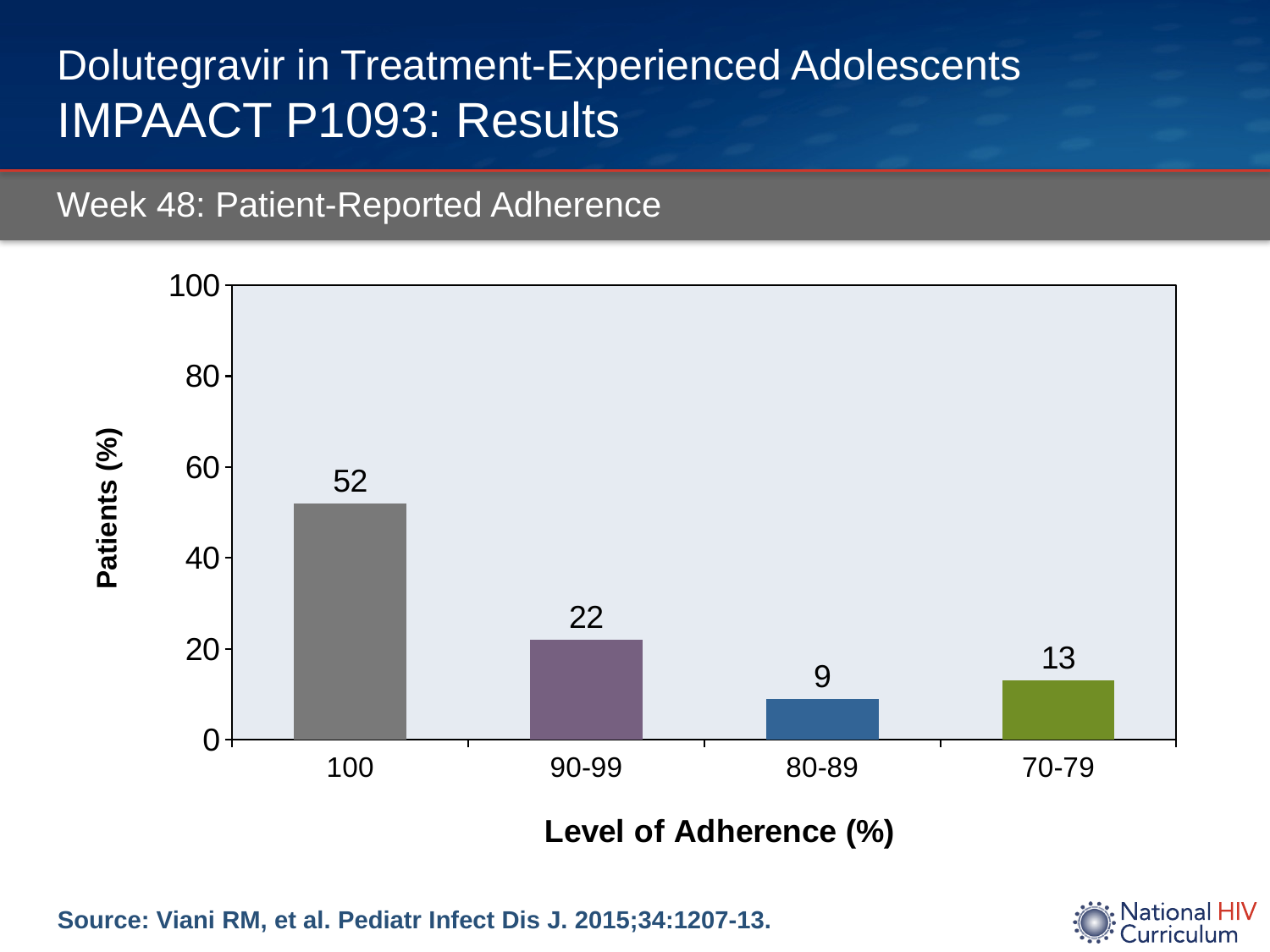
What percentage of patients reported 100% adherence? 52 What kind of chart is shown on the slide? bar chart Which has a larger value, the 70-79 or the 80-89 adherence level? 70-79 How many adherence level categories are shown on the x axis? 4 What is the value for the 70-79 adherence level? 13 Which level of adherence has the lowest percentage of patients? 80-89 What is the value for the 90-99 level of adherence? 22 What is the difference between the values for the 100 and 90-99 adherence levels? 30 What percentage of patients reported an adherence level of 80-89? 9 What is the label of the y axis? Patients (%) Is the value for the 100 adherence level greater or less than 40? greater Which level of adherence has the highest percentage of patients? 100